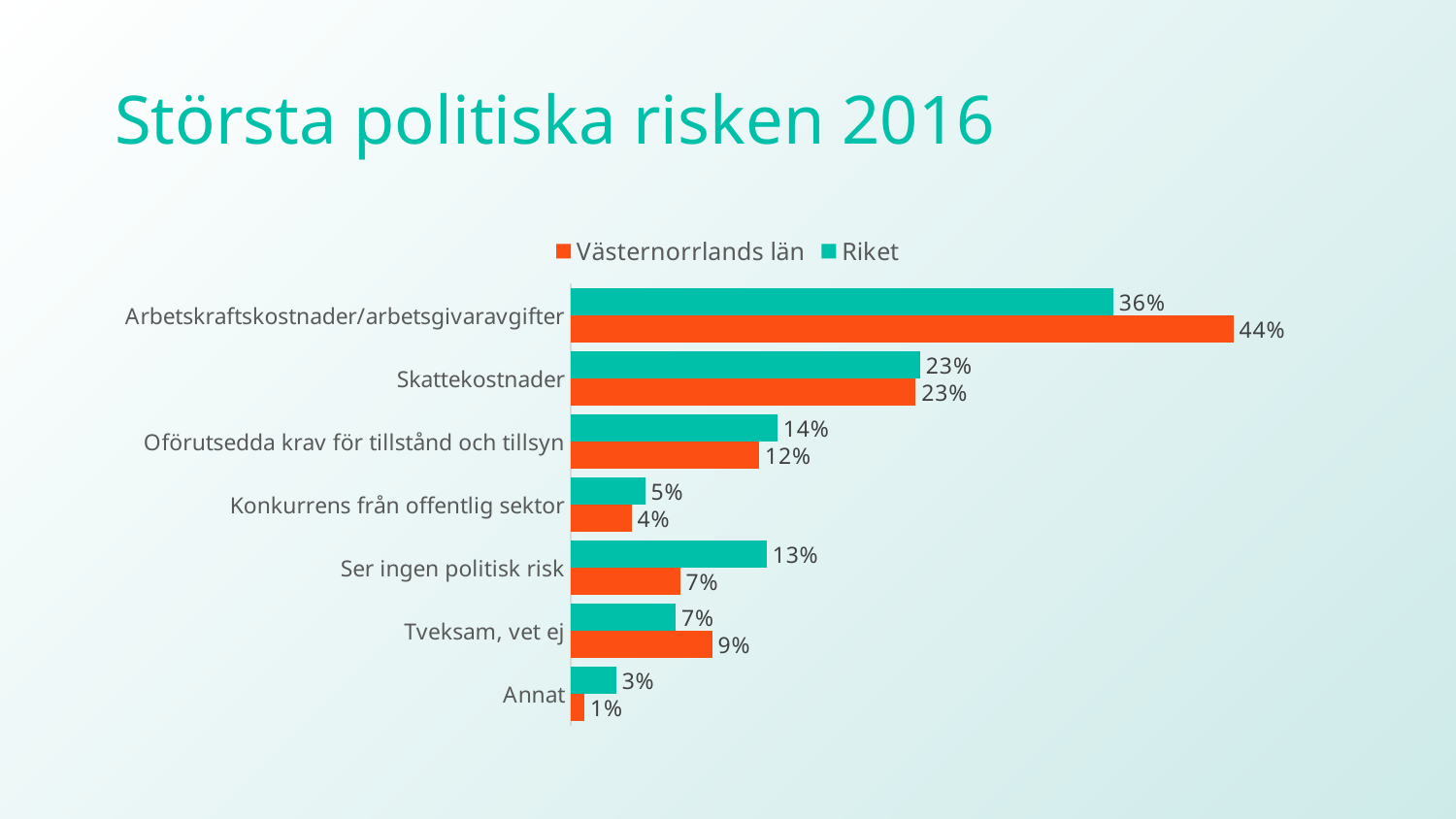
Which series has the larger value for Oförutsedda krav för tillstånd och tillsyn, Västernorrlands län or Riket? Riket What is the value for Västernorrlands län for Arbetskraftskostnader/arbetsgivaravgifter? 44% What is the value for Riket for Ser ingen politisk risk? 13% How many categories are shown on the chart? 7 Which category has the lowest value for Västernorrlands län? Annat What is the difference between Riket and Västernorrlands län for Ser ingen politisk risk? 6% What is the title of the chart on the slide? Största politiska risken 2016 What is the value for Västernorrlands län for Tveksam, vet ej? 9% Which category has the highest value for Riket? Arbetskraftskostnader/arbetsgivaravgifter How many series does the legend list? 2 What is the difference between Västernorrlands län and Riket for Arbetskraftskostnader/arbetsgivaravgifter? 8% What kind of chart is shown on the slide? Bar chart